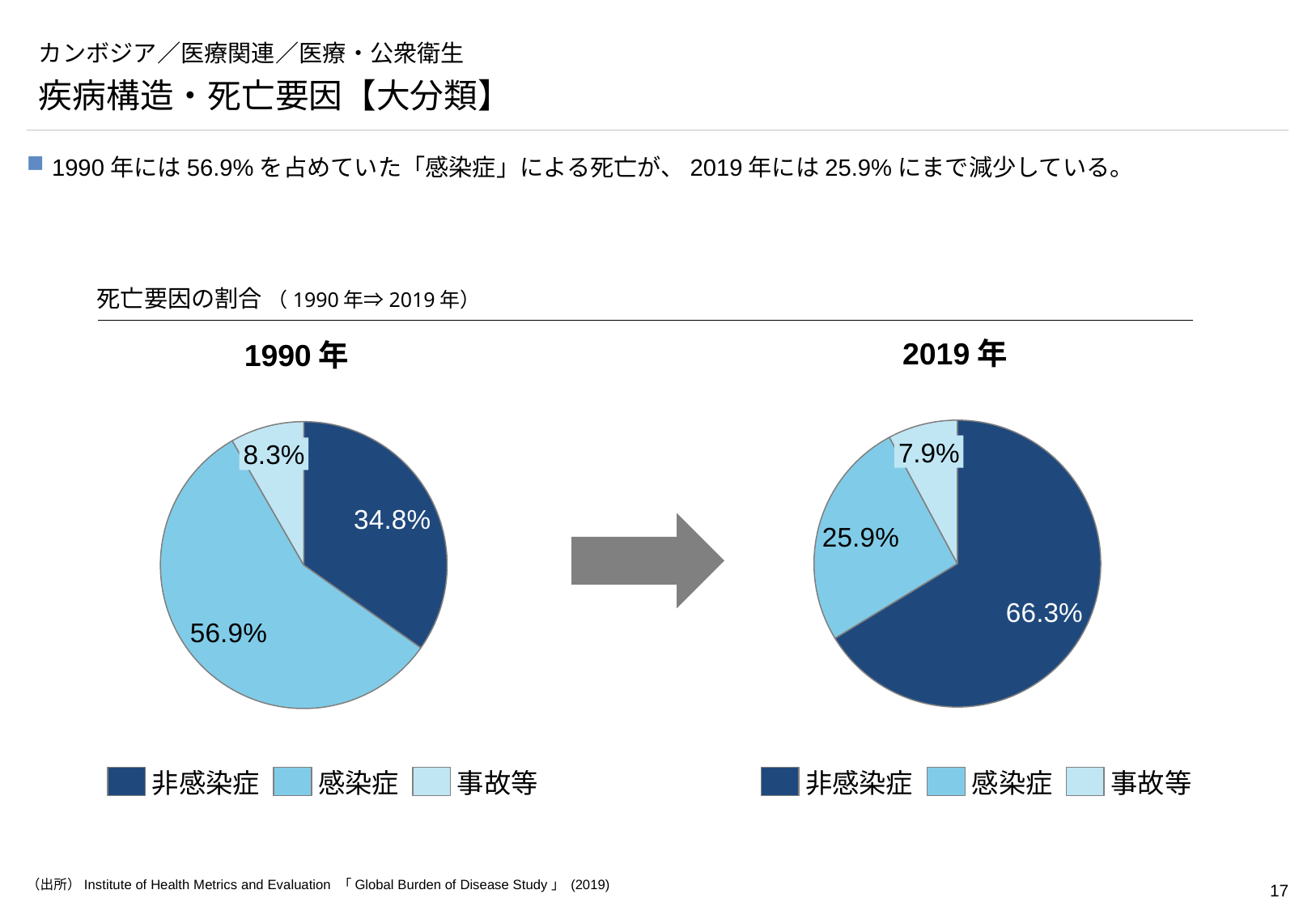
How many entries does the legend under the 1990年 pie chart list? 3 In the 1990年 pie chart, which category has the largest slice? 感染症 In the 1990年 pie chart, what share is labelled for 事故等? 8.3% What is the difference between the 感染症 share in the 1990年 pie chart and in the 2019年 pie chart? 31.0% In the 2019年 pie chart, what share is labelled for 非感染症? 66.3% What type of chart is used for the 2019年 data? Pie chart In the 2019年 pie chart, what share is labelled for 感染症? 25.9% In the 1990年 pie chart, which is larger: 非感染症 or 感染症? 感染症 In the 1990年 pie chart, what share is labelled for 感染症? 56.9% In the 2019年 pie chart, what is the difference between the 非感染症 and 感染症 shares? 40.4% How many slices does the 1990年 pie chart have? 3 In the 2019年 pie chart, which category has the smallest slice? 事故等